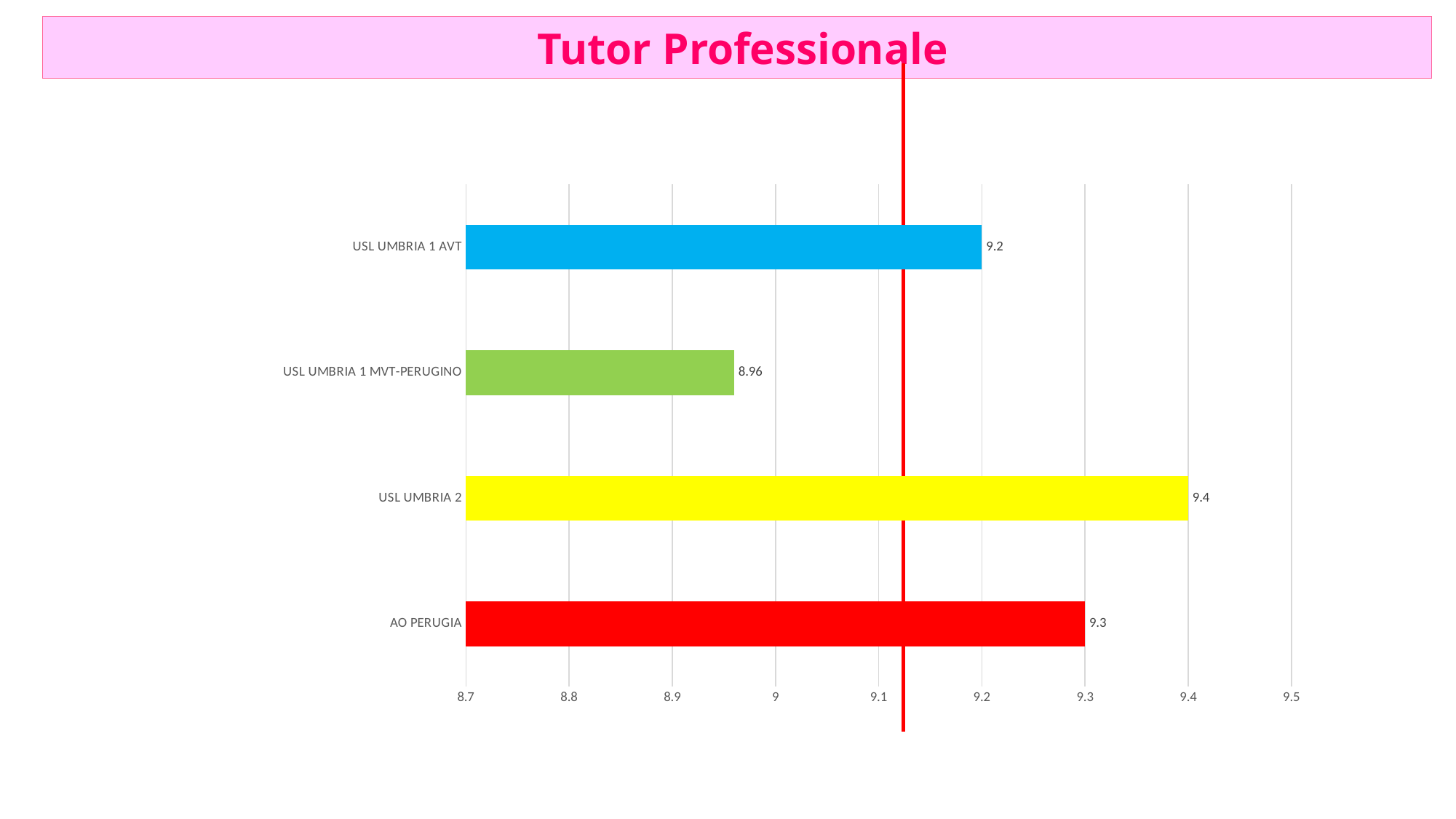
What is the difference between the values for USL UMBRIA 2 and USL UMBRIA 1 MVT-PERUGINO? 0.44 What is the value for USL UMBRIA 1 AVT? 9.2 Is the value for USL UMBRIA 1 MVT-PERUGINO greater or less than 9? less Which category has the lowest value? USL UMBRIA 1 MVT-PERUGINO How many categories are shown in the chart? 4 Which is larger, the value for AO PERUGIA or the value for USL UMBRIA 1 AVT? AO PERUGIA What is the value for USL UMBRIA 2? 9.4 Which category has the highest value? USL UMBRIA 2 What is the value for USL UMBRIA 1 MVT-PERUGINO? 8.96 What kind of chart is shown on the slide? bar chart What is the value for AO PERUGIA? 9.3 What is the title of the slide? Tutor Professionale